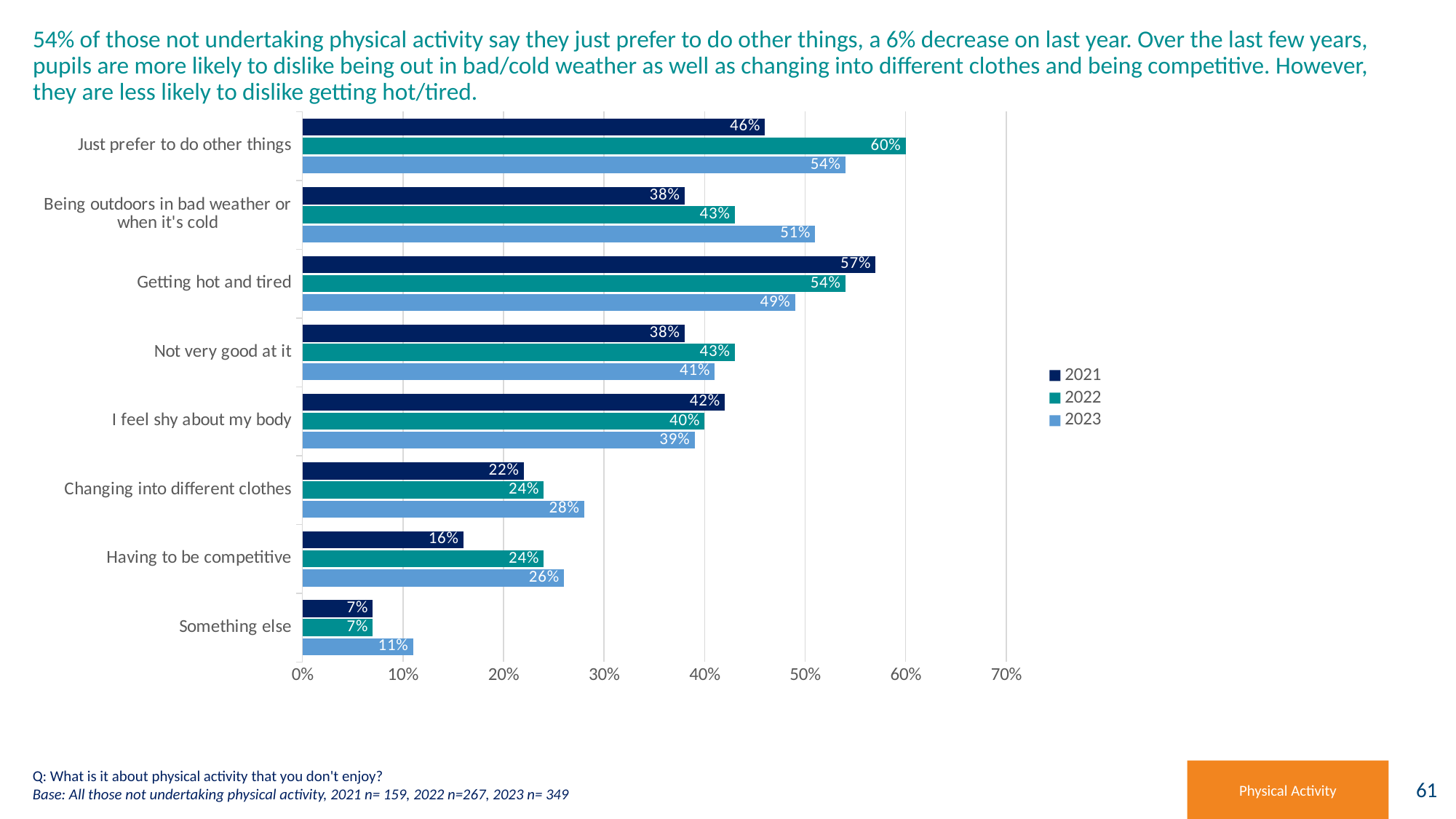
How many categories are shown on the chart? 8 What is the 2021 value for 'Getting hot and tired'? 57% What is the difference between the 2021 and 2023 values for 'Getting hot and tired'? 8% How many series does the legend list? 3 Which category has the highest 2022 value? Just prefer to do other things What is the 2022 value for 'Having to be competitive'? 24% What kind of chart is shown on the slide? Bar chart Which category has the lowest 2023 value? Something else What is the 2023 value for 'Just prefer to do other things'? 54% Which years are listed in the chart legend? 2021, 2022, 2023 What is the difference between the 2022 and 2023 values for 'Just prefer to do other things'? 6% Which is larger for 'Being outdoors in bad weather or when it's cold': the 2021 value or the 2023 value? 2023